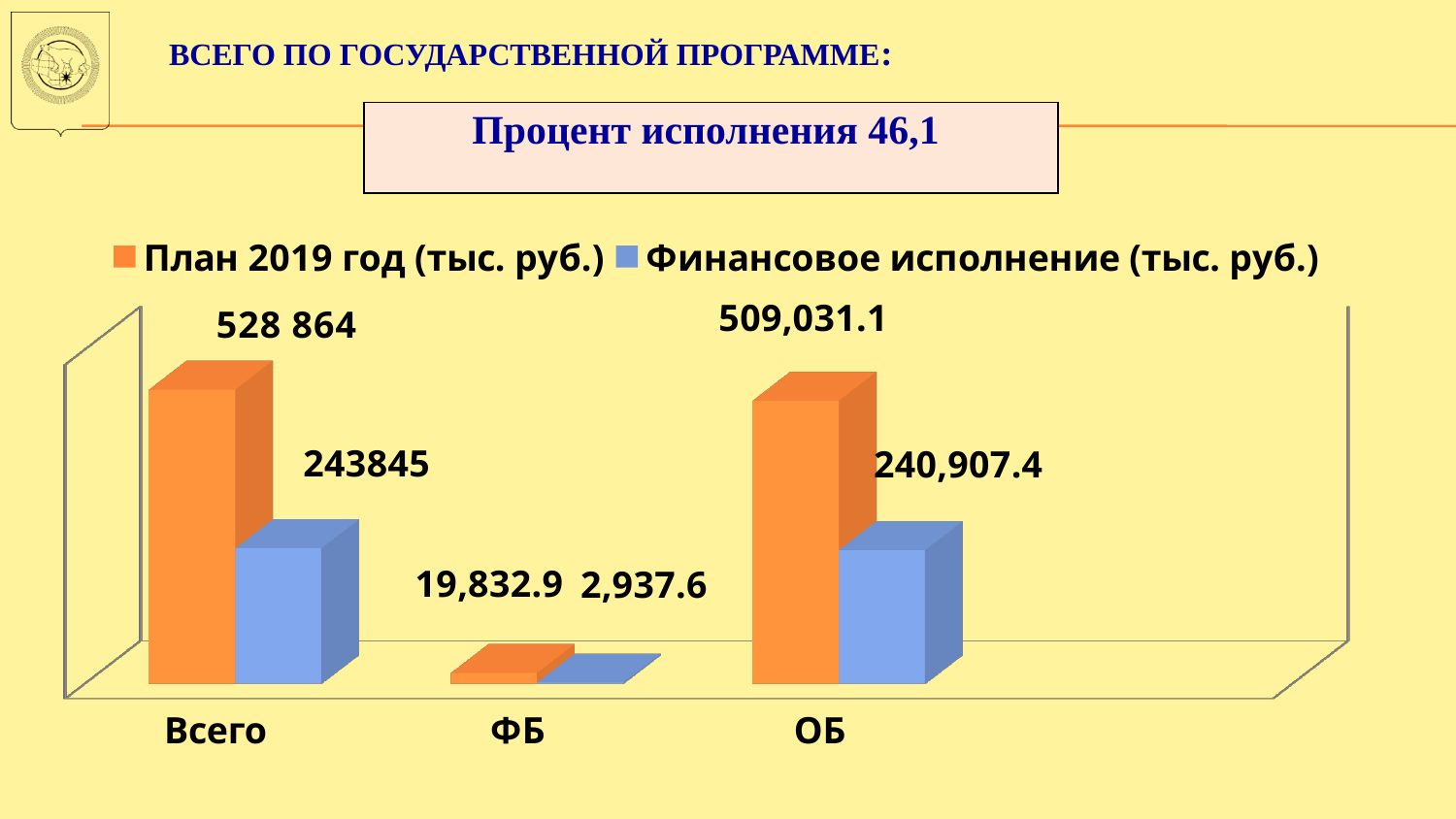
How many series does the legend list? 2 What kind of chart is shown on the slide? Bar chart What is the value of Финансовое исполнение (тыс. руб.) for ОБ? 240,907.4 What is the difference between План 2019 год and Финансовое исполнение for ОБ? 268,123.7 What is the value of Финансовое исполнение (тыс. руб.) for ФБ? 2,937.6 Which is larger for ОБ: План 2019 год or Финансовое исполнение? План 2019 год What is the value of План 2019 год (тыс. руб.) for ФБ? 19,832.9 How many categories are shown on the x axis? 3 Which category has the lowest value for План 2019 год (тыс. руб.)? ФБ Which category has the highest value for Финансовое исполнение (тыс. руб.)? Всего What is the difference between План 2019 год and Финансовое исполнение for ФБ? 16,895.3 What is the value of План 2019 год (тыс. руб.) for Всего? 528 864